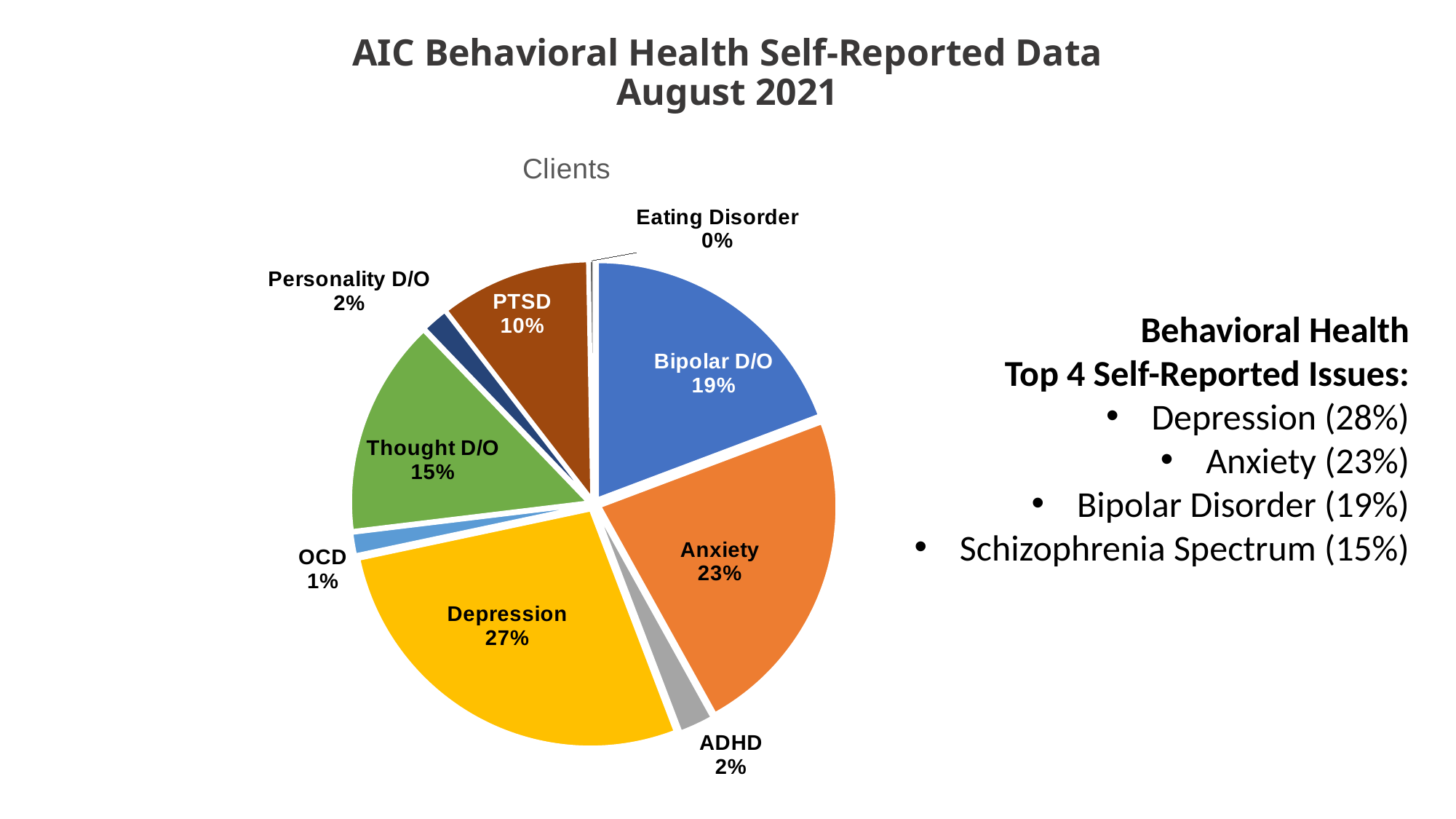
Which is larger, the share for Bipolar D/O or the share for Thought D/O? Bipolar D/O What share of the pie does Depression have? 27% Which category has the largest slice of the pie? Depression Which category has the smallest slice of the pie? Eating Disorder How many categories are shown in the pie chart? 9 What share of the pie does Anxiety have? 23% What type of chart is shown on the slide? Pie chart What share of the pie does PTSD have? 10% What is the difference in percentage points between Depression and Anxiety? 4%